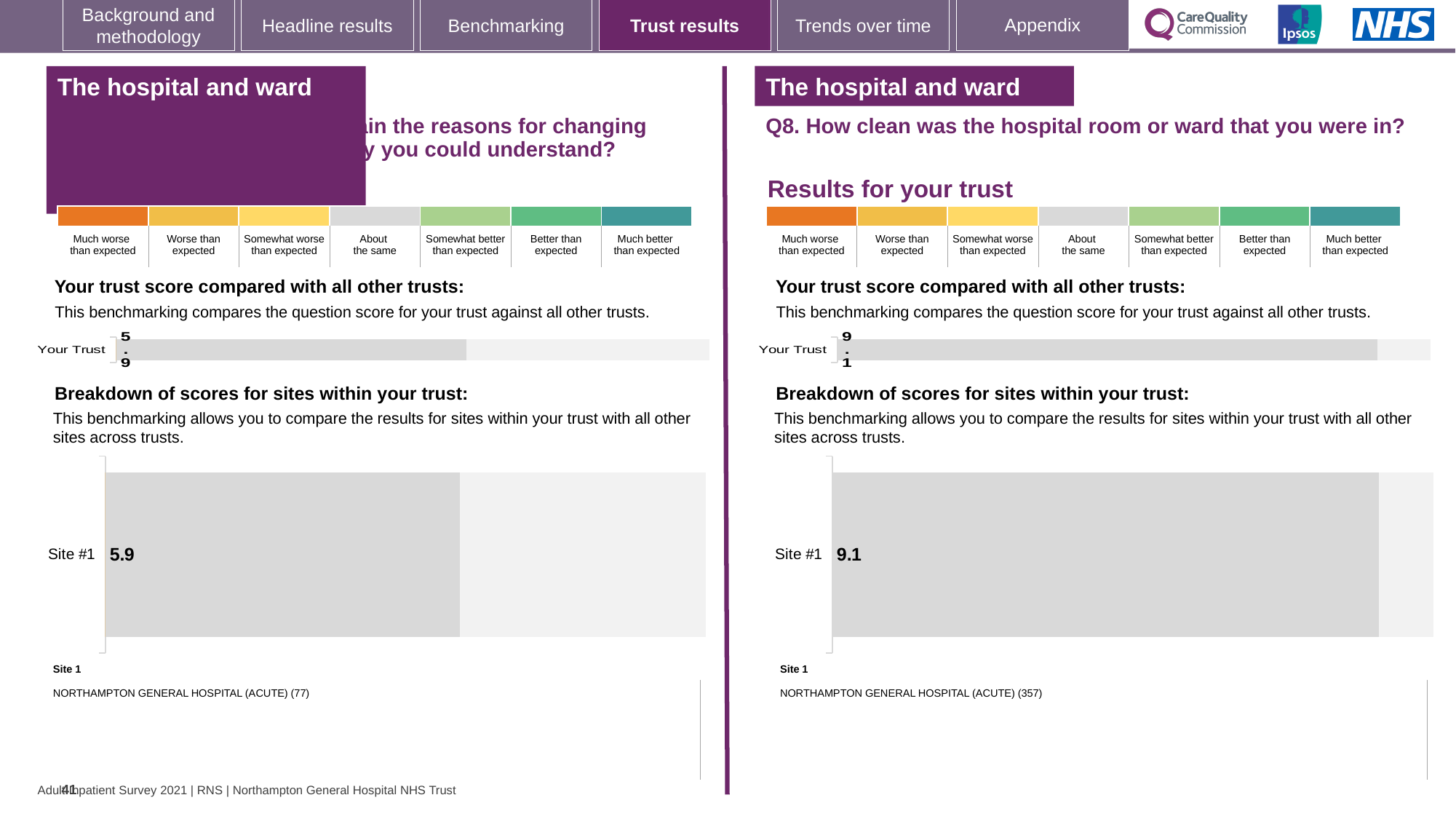
On the right-hand Q8 'Breakdown of scores for sites within your trust' chart, what is the score for Site #1? 9.1 On the left-hand 'Breakdown of scores for sites within your trust' chart, what is the score for Site #1? 5.9 What kind of chart is used to show the Site #1 score on the right-hand Q8 breakdown? Bar chart Which is larger: the Your Trust score on the left-hand chart or the Your Trust score on the right-hand Q8 chart? The right-hand Q8 chart On the left-hand breakdown chart, which site is listed as Site 1? NORTHAMPTON GENERAL HOSPITAL (ACUTE) (77) How many sites are shown in the left-hand 'Breakdown of scores for sites within your trust' chart? 1 Is the Your Trust score on the left-hand chart the same as the Site #1 score on the left-hand breakdown chart? Yes On the left-hand 'Your trust score compared with all other trusts' chart, what is the score for Your Trust? 5.9 On the right-hand Q8 breakdown chart, which site is listed as Site 1? NORTHAMPTON GENERAL HOSPITAL (ACUTE) (357) On the right-hand Q8 'Your trust score compared with all other trusts' chart, what is the score for Your Trust? 9.1 How many bars are plotted in the right-hand Q8 'Your trust score compared with all other trusts' chart? 1 What is the difference between the Site #1 score on the right-hand Q8 chart and the Site #1 score on the left-hand chart? 3.2